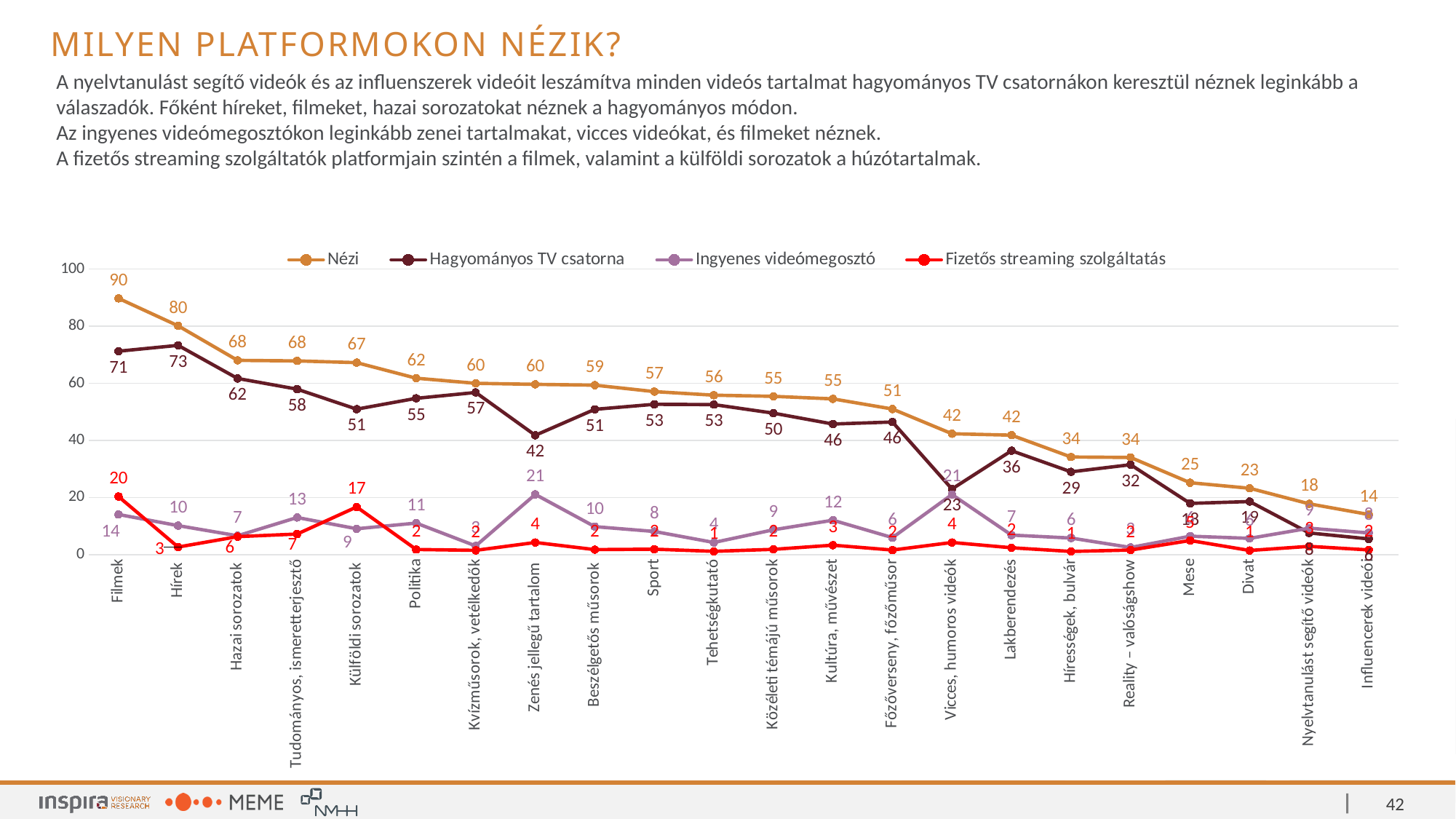
Which category has the highest value in the Nézi series? Filmek What is the value of the Hagyományos TV csatorna series for Hírek? 73 How many categories are shown on the x axis? 22 For Lakberendezés, which is larger: the Hagyományos TV csatorna value or the Ingyenes videómegosztó value? Hagyományos TV csatorna What is the value of the Fizetős streaming szolgáltatás series for Külföldi sorozatok? 17 What is the difference between the Nézi values for Filmek and Hírek? 10 What kind of chart is shown on the slide? Line chart What is the value of the Ingyenes videómegosztó series for Zenés jellegű tartalom? 21 Does the Nézi series rise or fall from left to right along the x axis? Fall What is the value of the Nézi series for Filmek? 90 How many series does the legend list? 4 Which category has the lowest value in the Nézi series? Influencerek videói